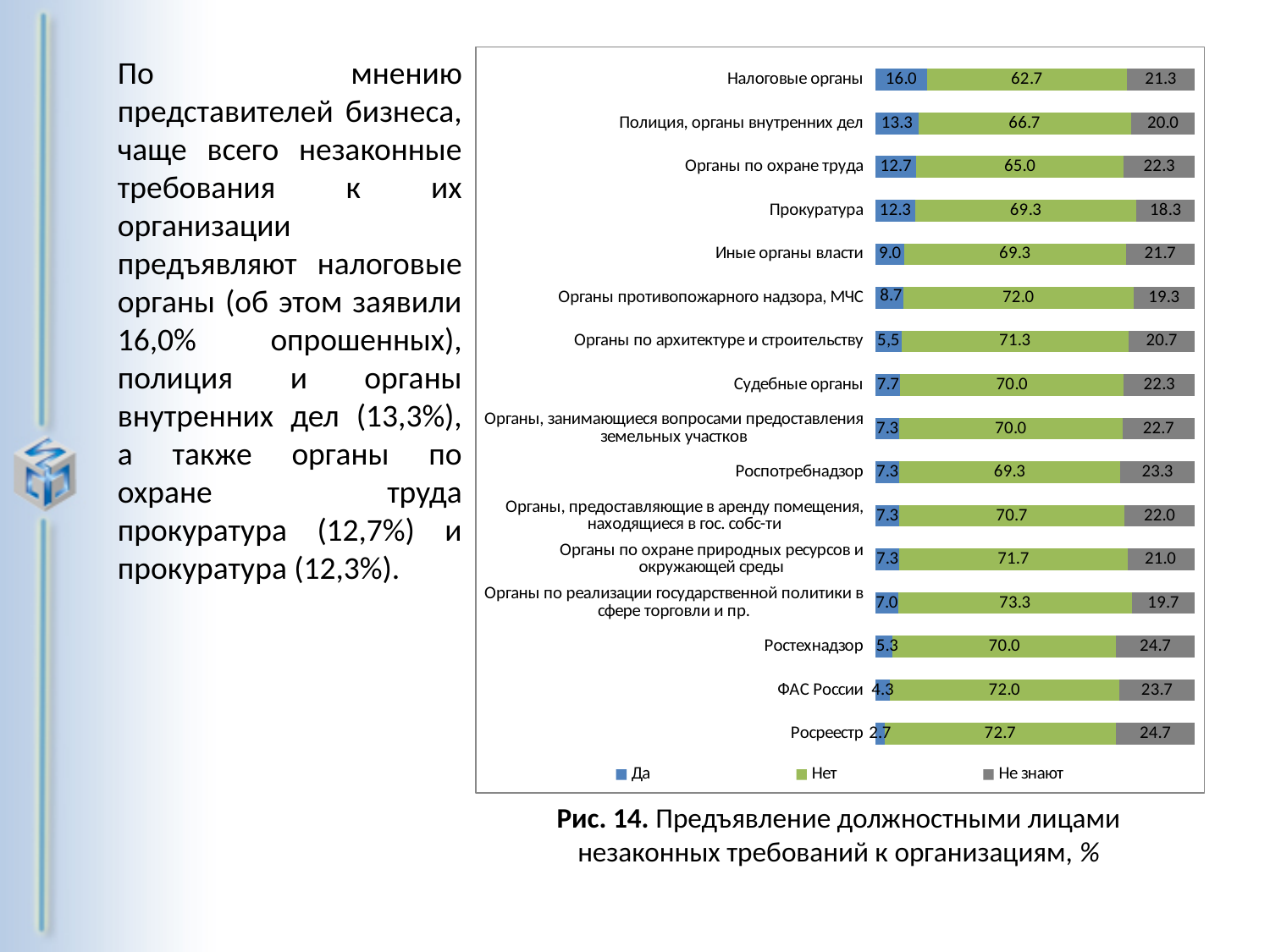
Which category has the highest value in the "Нет" series? Органы по реализации государственной политики в сфере торговли и пр. What is the value of the "Да" series for Налоговые органы? 16.0 How many series does the legend list? 3 What kind of chart is shown on the slide? Stacked bar chart What is the difference between the "Да" values for Налоговые органы and Полиция, органы внутренних дел? 2.7 What is the value of the "Не знают" series for Росреестр? 24.7 What is the value of the "Нет" series for Прокуратура? 69.3 Which category has the lowest value in the "Да" series? Росреестр Which has a larger "Не знают" value: Ростехнадзор or Прокуратура? Ростехнадзор How many categories (organisations) are plotted in the chart? 16 What is the total of the stacked bar for Налоговые органы? 100.0 Which category has the highest value in the "Да" series? Налоговые органы